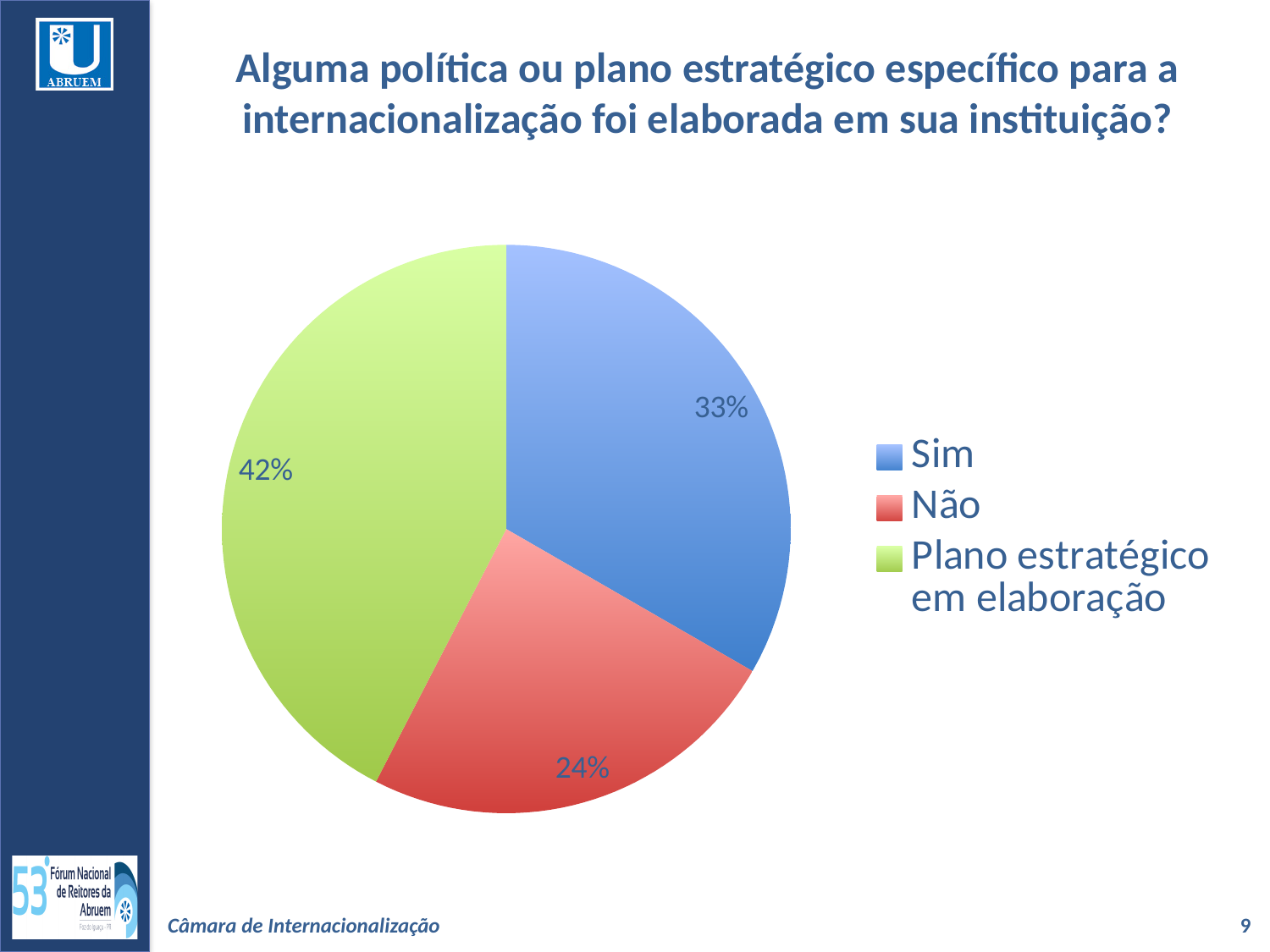
What colour is the slice for "Não"? red Which category has the largest share of the pie? Plano estratégico em elaboração How many slices does the pie chart have? 3 How many entries does the legend list? 3 What percentage of the pie is labelled for "Sim"? 33% Which category has the smallest share of the pie? Não What percentage of the pie is labelled for "Plano estratégico em elaboração"? 42% What kind of chart is shown on the slide? pie chart What percentage of the pie is labelled for "Não"? 24% What is the difference in percentage points between "Plano estratégico em elaboração" and "Sim"? 9 Which is larger, the share for "Sim" or the share for "Não"? Sim What is the difference in percentage points between "Sim" and "Não"? 9